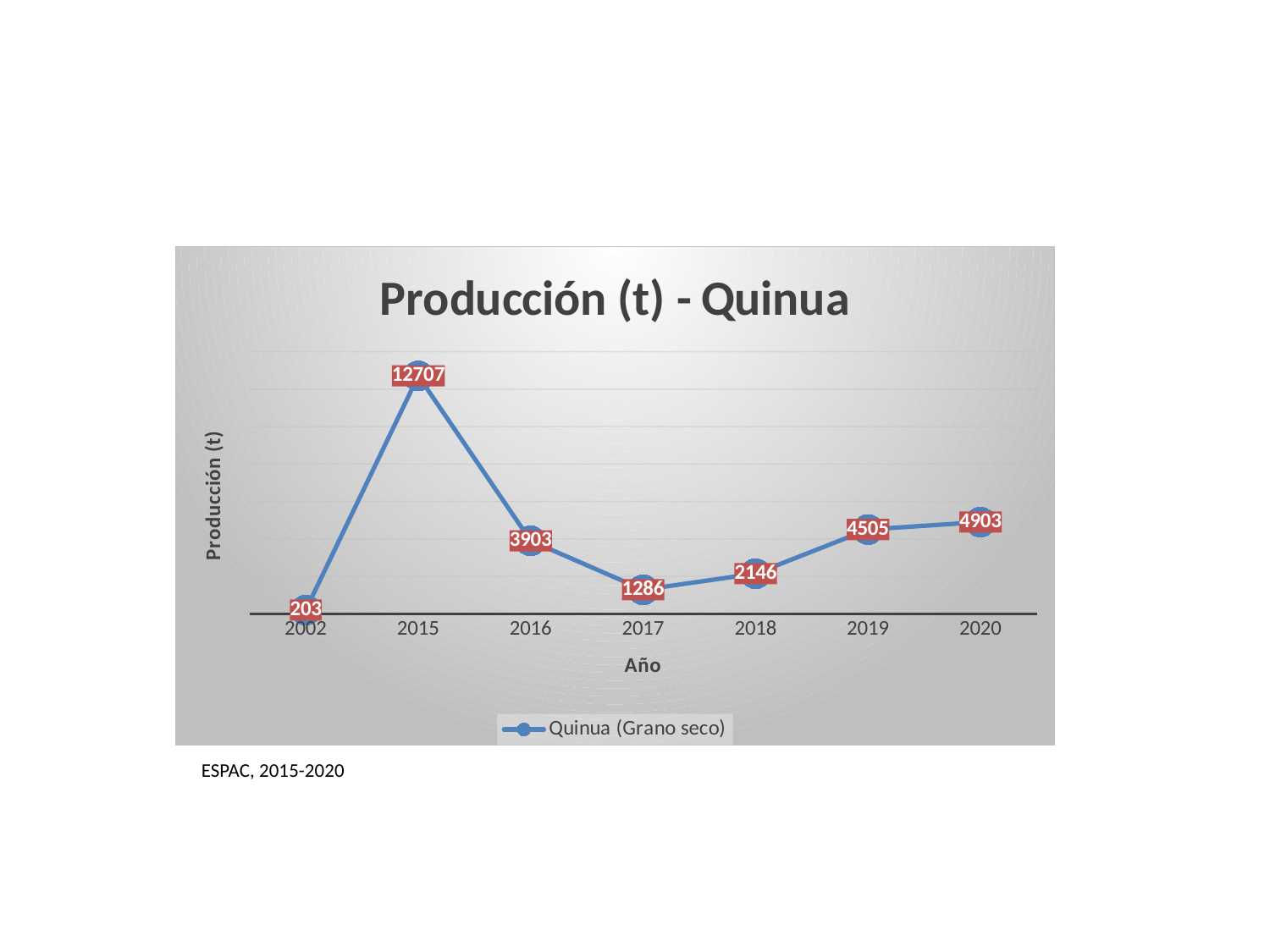
Which year has the highest production? 2015 Which year has higher production, 2018 or 2016? 2016 Which year has the lowest production? 2002 How many years are plotted on the chart? 7 What kind of chart is shown? line chart What is the production value for 2017? 1286 What is the difference in production between 2016 and 2017? 2617 What is the difference in production between 2020 and 2019? 398 Does production rise or fall from 2017 to 2020? rise What is the production value for 2015? 12707 What is the production value for 2020? 4903 How many series does the legend list? 1